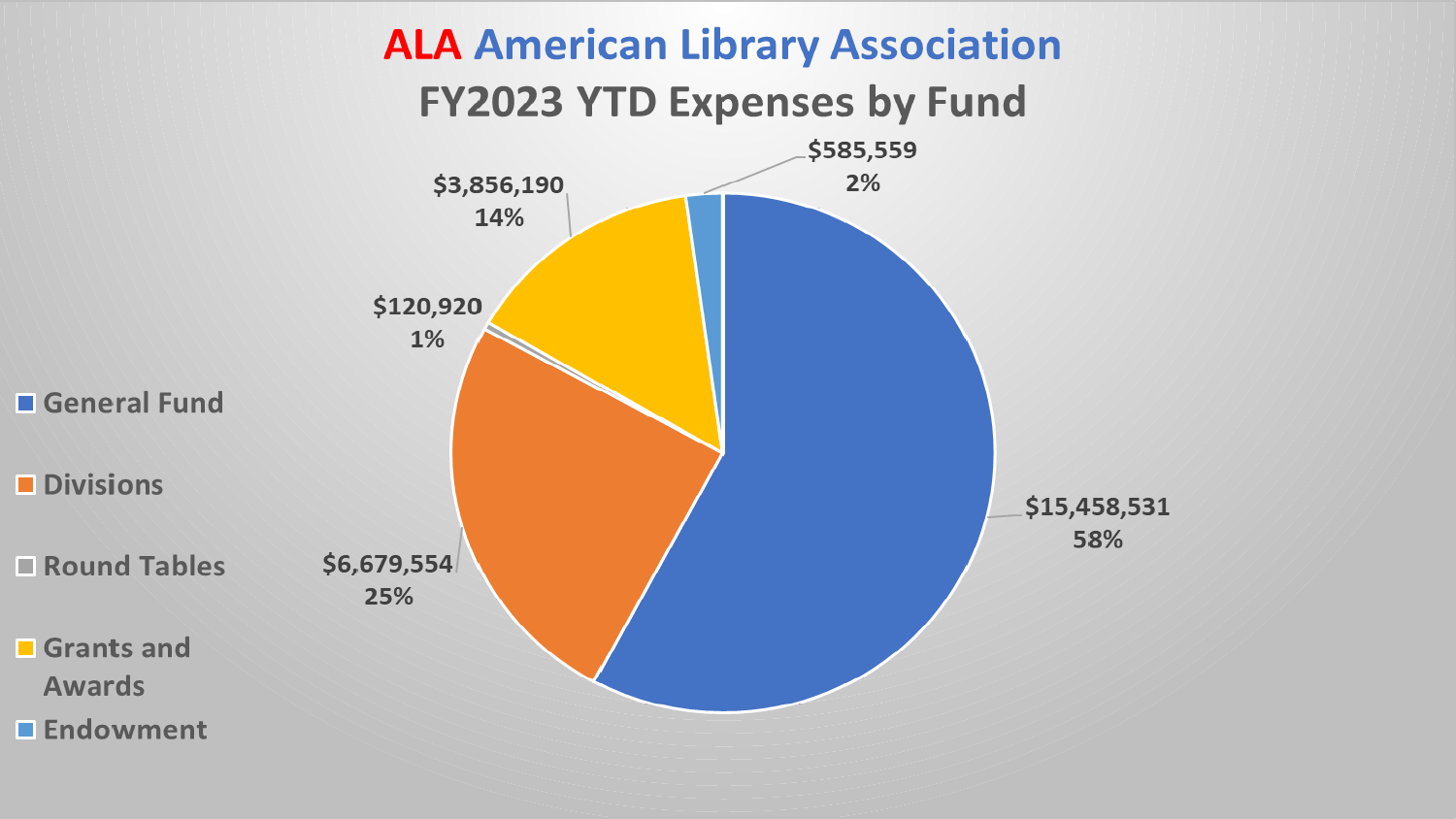
What share of the pie does General Fund represent? 58% What kind of chart is shown on the slide? Pie chart What is the value for Grants and Awards? $3,856,190 What share of the pie does Round Tables represent? 1% What is the value for Divisions? $6,679,554 What is the difference between General Fund and Divisions expenses? $8,778,977 What is the value for General Fund? $15,458,531 Which fund has the lowest expenses? Round Tables How many funds are shown in the pie chart? 5 Which is larger, Grants and Awards or Endowment? Grants and Awards Which fund has the highest expenses? General Fund What is the value for Endowment? $585,559